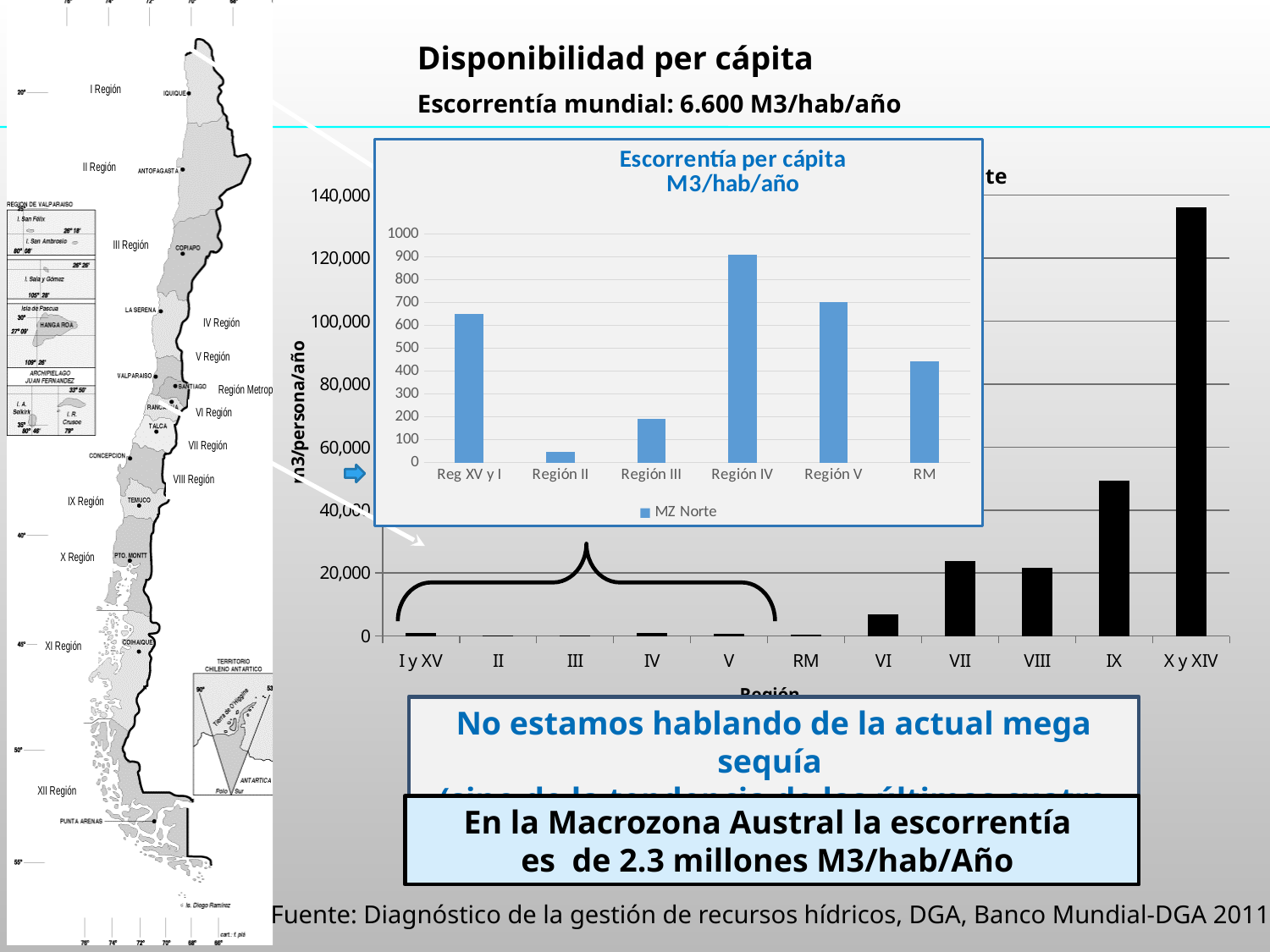
In the inset chart 'Escorrentía per cápita M3/hab/año', is the value for Región II greater or less than 100? less How many categories does the inset chart 'Escorrentía per cápita M3/hab/año' show? 6 In the inset chart 'Escorrentía per cápita M3/hab/año', is the value for RM greater or less than 500? less In the large black bar chart, which region has the highest value? X y XIV In the large black bar chart, is the value for X y XIV greater or less than 120,000? greater What series name does the legend of the inset chart 'Escorrentía per cápita M3/hab/año' list? MZ Norte In the large black bar chart, which is larger, IX or VII? IX What kind of chart is the inset chart titled 'Escorrentía per cápita M3/hab/año'? bar chart In the inset chart 'Escorrentía per cápita M3/hab/año', which is larger, Región V or RM? Región V In the inset chart 'Escorrentía per cápita M3/hab/año', which region has the lowest value? Región II In the inset chart 'Escorrentía per cápita M3/hab/año', which region has the highest value? Región IV